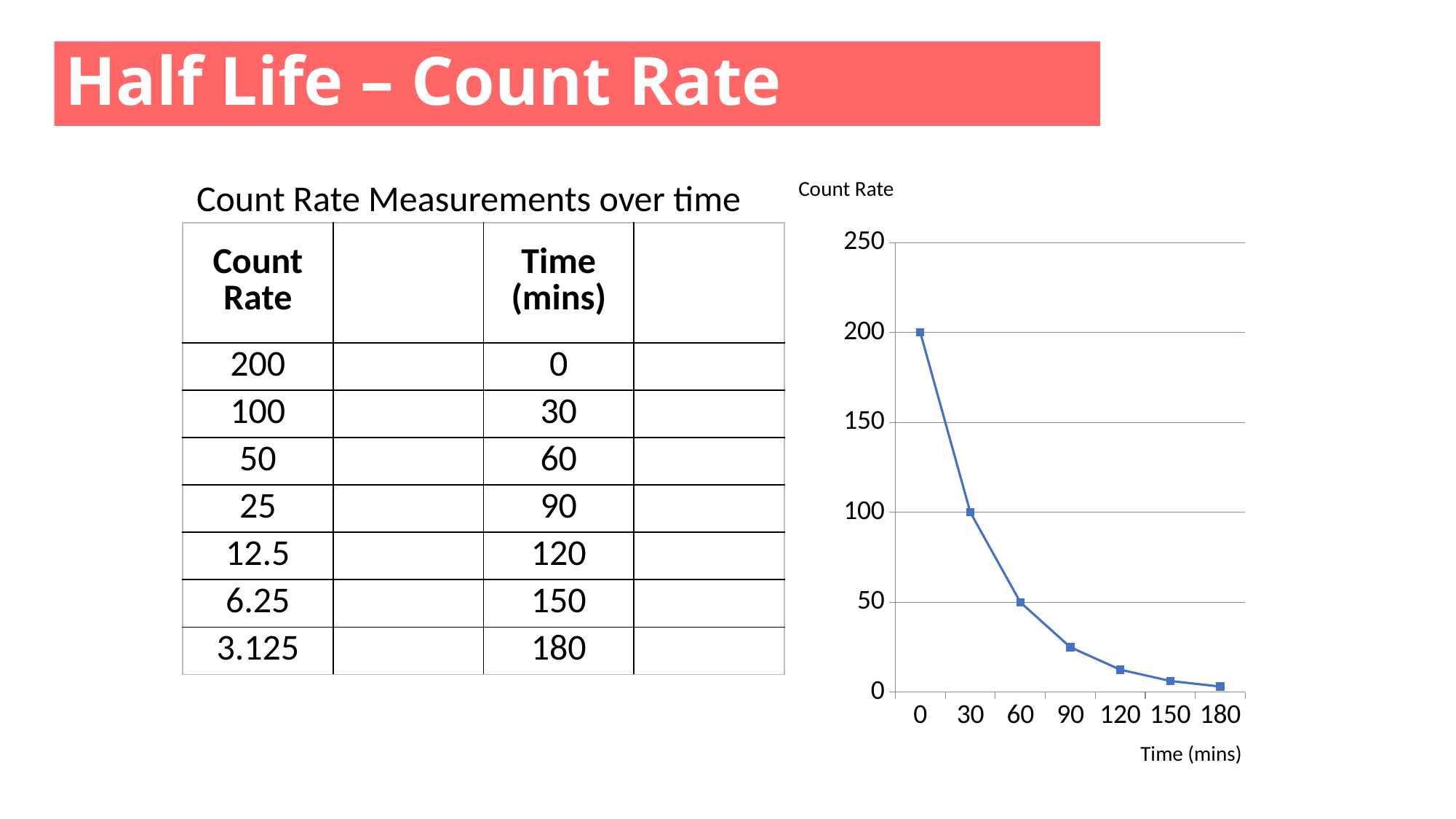
Which is larger on the chart, the count rate at 30 mins or at 120 mins? 30 mins How many data points are plotted on the chart? 7 Is the count rate at 90 mins greater or less than 50? less At which time is the count rate highest on the chart? 0 What is the count rate at 60 mins on the chart? 50 What is the count rate at time 0 mins on the chart? 200 What is the label of the x axis on the chart? Time (mins) Does the count rate rise or fall as time increases along the x axis? fall What kind of chart is shown on the slide? line chart What is the difference between the count rate at 0 mins and at 30 mins? 100 What is the count rate at 30 mins on the chart? 100 At which time is the count rate lowest on the chart? 180